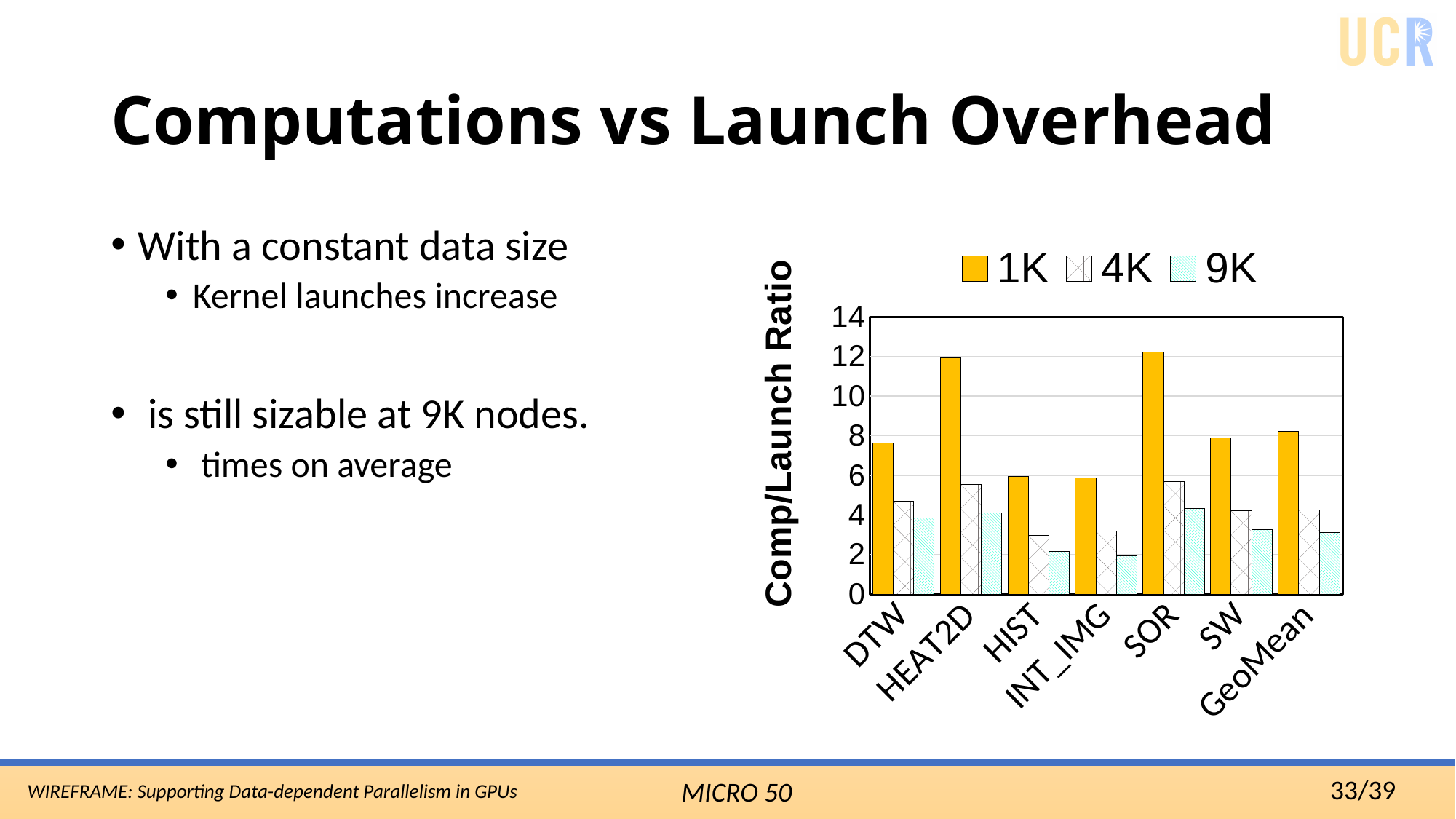
Is the 4K value for HIST greater or less than 4? less Is the 1K value for HEAT2D greater or less than 10? greater How many series does the legend list? 3 Is the 9K value for INT_IMG greater or less than 4? less What kind of chart is shown on the slide? bar chart Which category has the larger 1K value, HEAT2D or HIST? HEAT2D What is the y-axis label of the chart? Comp/Launch Ratio How many categories are shown on the x axis? 7 Which is larger for SOR, the 1K value or the 4K value? 1K Which series is drawn with solid orange bars? 1K